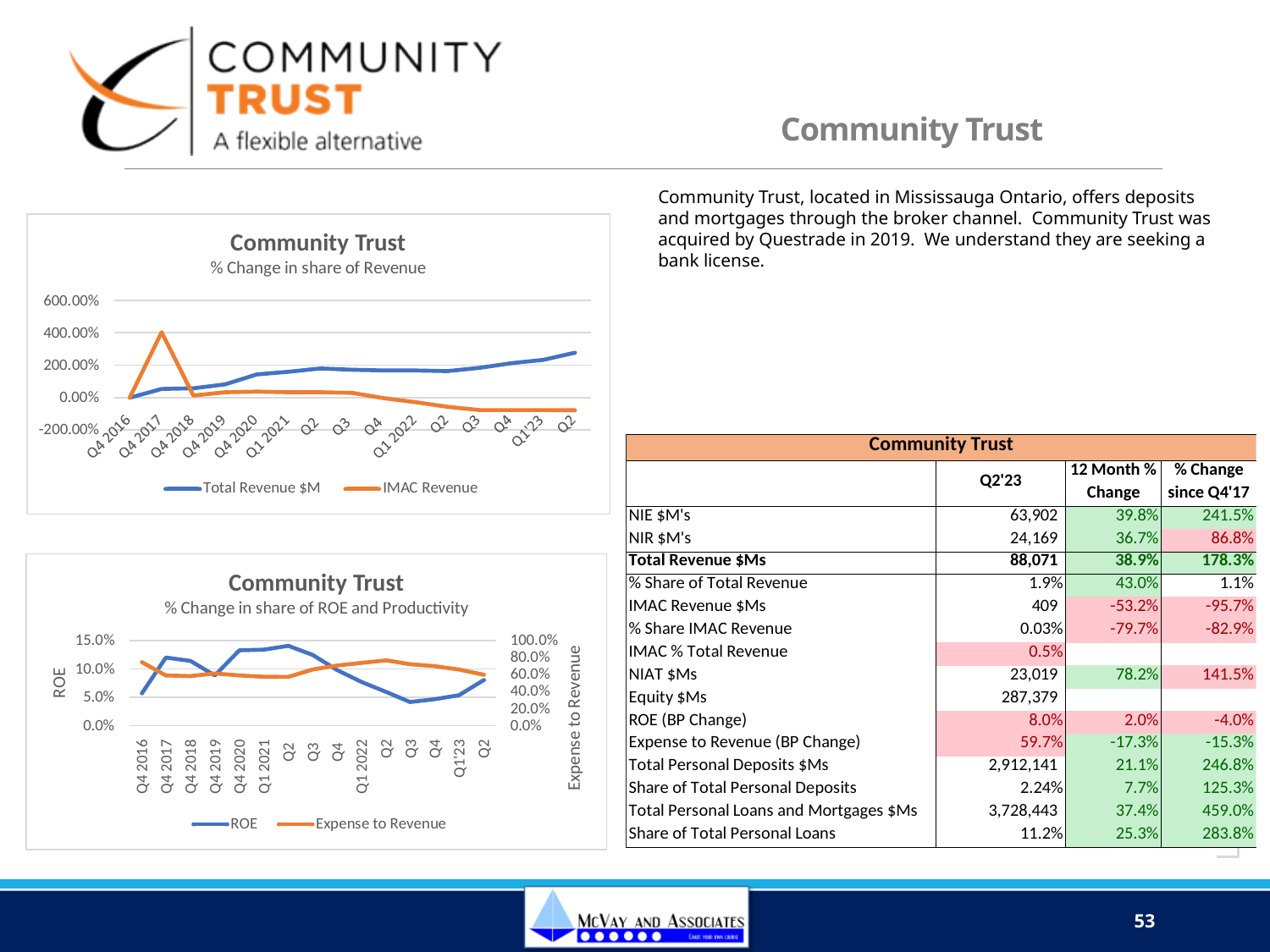
In the top chart (% Change in share of Revenue), does the Total Revenue $M line generally rise or fall from Q4 2016 to the final Q2 point? rise In the top chart (% Change in share of Revenue), at the final Q2 point, which series is higher: Total Revenue $M or IMAC Revenue? Total Revenue $M In the bottom chart (% Change in share of ROE and Productivity), how many series does the legend list? 2 In the top chart (% Change in share of Revenue), how many series does the legend list? 2 In the top chart (% Change in share of Revenue), at which period does IMAC Revenue reach its highest value? Q4 2017 What type of chart is the top chart titled 'Community Trust % Change in share of Revenue'? line chart What type of chart is the bottom chart titled 'Community Trust % Change in share of ROE and Productivity'? line chart In the bottom chart (% Change in share of ROE and Productivity), is the ROE value at Q4 2016 greater or less than 10.0%? less In the top chart (% Change in share of Revenue), is the Total Revenue $M value at the final Q2 point greater or less than 200.00%? greater In the top chart (% Change in share of Revenue), how many points are plotted along the x axis for each series? 15 In the bottom chart (% Change in share of ROE and Productivity), what is the label on the right-hand vertical axis? Expense to Revenue In the top chart (% Change in share of Revenue), is the IMAC Revenue value at Q4 2017 greater or less than 200.00%? greater